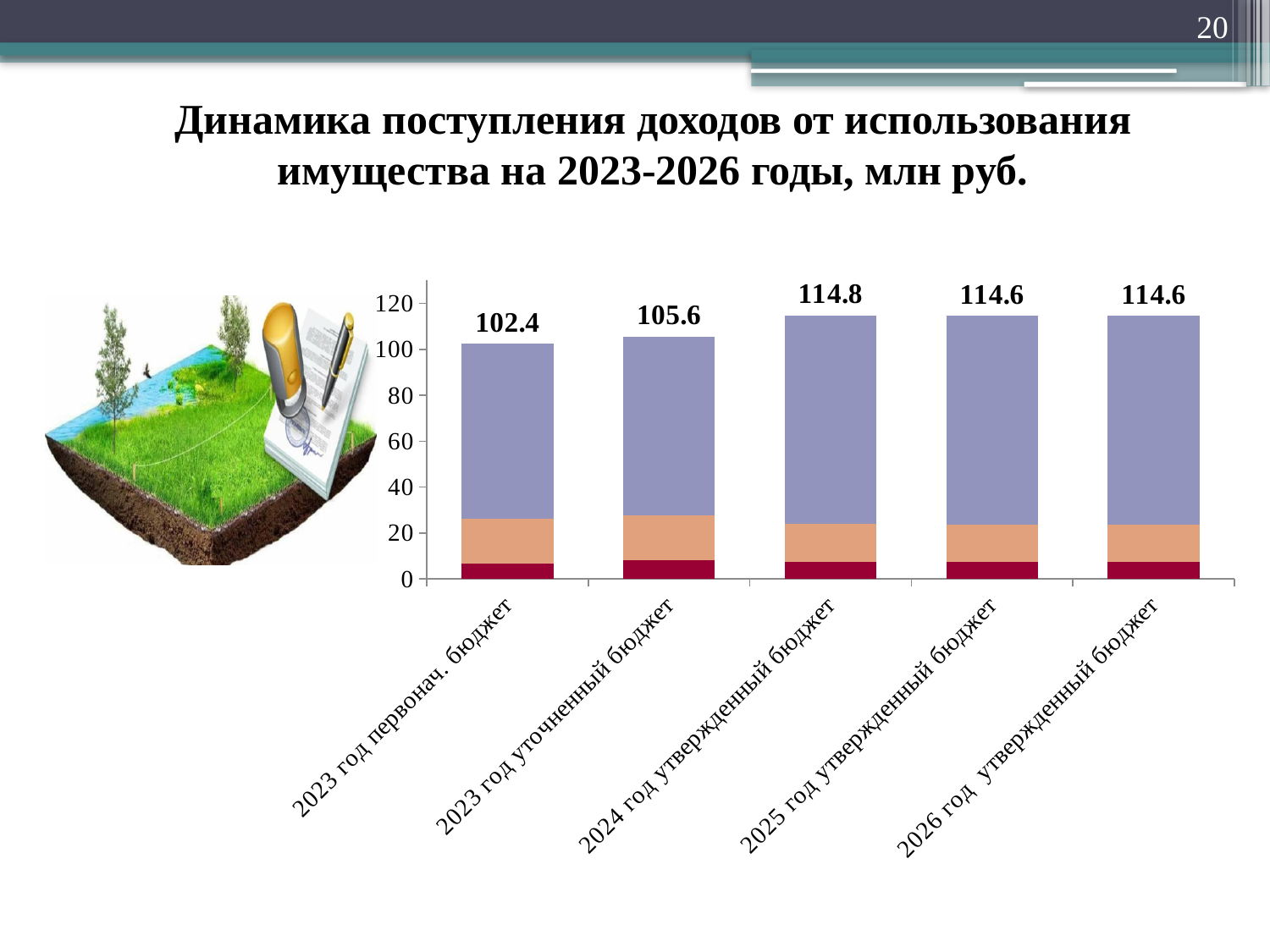
Which is larger: the total for "2024 год утвержденный бюджет" or for "2025 год утвержденный бюджет"? 2024 год утвержденный бюджет What is the difference between the totals for "2023 год уточненный бюджет" and "2023 год первонач. бюджет"? 3.2 What is the total value labelled for the bar "2023 год уточненный бюджет"? 105.6 Which category has the lowest labelled total? 2023 год первонач. бюджет How many bars (categories) are shown on the chart? 5 What is the total value labelled for the bar "2024 год утвержденный бюджет"? 114.8 Do the labelled totals rise or fall from "2023 год первонач. бюджет" to "2024 год утвержденный бюджет"? rise What is the total value labelled for the bar "2026 год утвержденный бюджет"? 114.6 Is the total for "2023 год первонач. бюджет" greater or less than 120? less Which category has the highest labelled total? 2024 год утвержденный бюджет What is the total value labelled for the bar "2023 год первонач. бюджет"? 102.4 What kind of chart is shown on the slide? Stacked bar chart